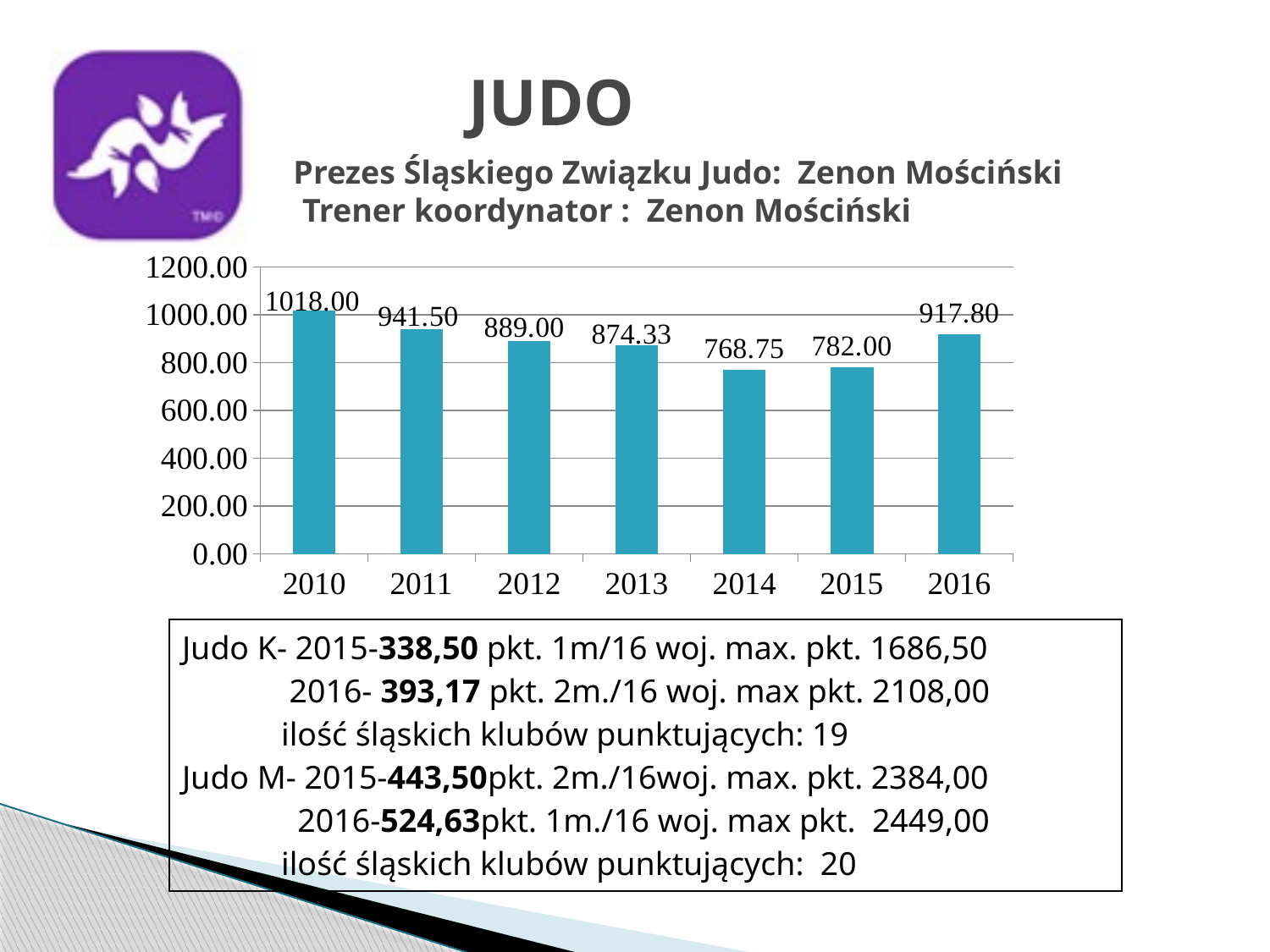
What is the difference between the values for 2015 and 2014? 13.25 What kind of chart is shown on the slide? bar chart What is the value for 2010? 1018.00 Do the values rise or fall from 2010 to 2014? fall What is the difference between the values for 2010 and 2011? 76.50 Which is larger, the value for 2012 or the value for 2013? 2012 What is the value for 2014? 768.75 Is the value for 2016 greater or less than 1000.00? less What is the value for 2016? 917.80 Which year has the highest value? 2010 How many years are shown on the x axis? 7 Which year has the lowest value? 2014